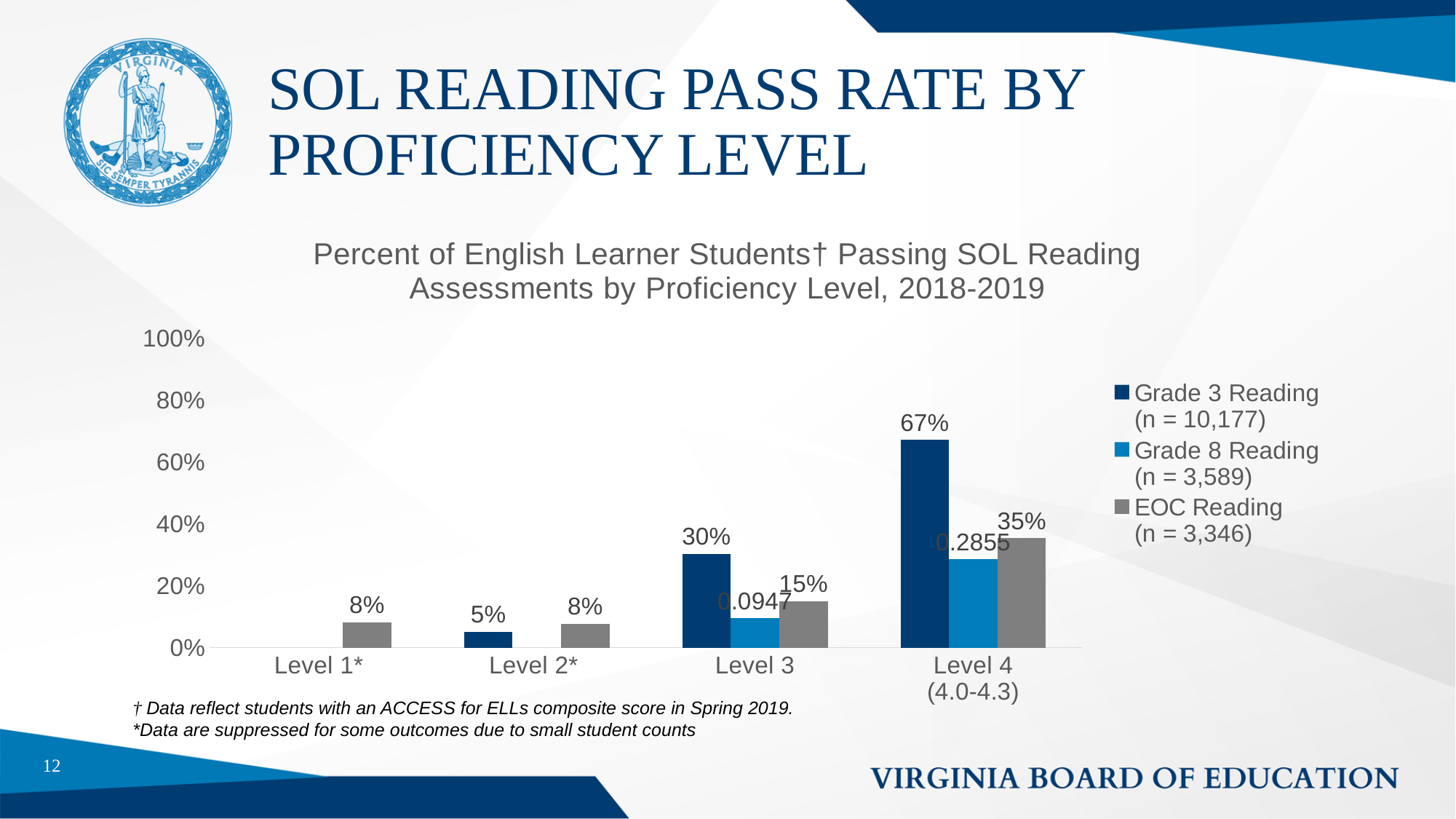
Which proficiency level has the highest Grade 3 Reading pass rate? Level 4 (4.0-4.3) What is the Grade 3 Reading pass rate for Level 2*? 5% What data label is shown for Grade 8 Reading at Level 3? 0.0947 Is the Grade 8 Reading value for Level 4 (4.0-4.3) greater or less than 40%? less Which proficiency level has the lowest EOC Reading pass rate? Level 1* and Level 2* (both 8%) How many series does the legend list? 3 What is the EOC Reading pass rate for Level 3? 15% What is the Grade 3 Reading pass rate for Level 4 (4.0-4.3)? 67% How many proficiency level categories are shown on the x axis? 4 Does the EOC Reading pass rate rise or fall from Level 2* to Level 4 (4.0-4.3)? rise What is the difference between the Grade 3 Reading and EOC Reading pass rates at Level 4 (4.0-4.3)? 32 percentage points At Level 3, which is larger: the Grade 3 Reading pass rate or the EOC Reading pass rate? Grade 3 Reading